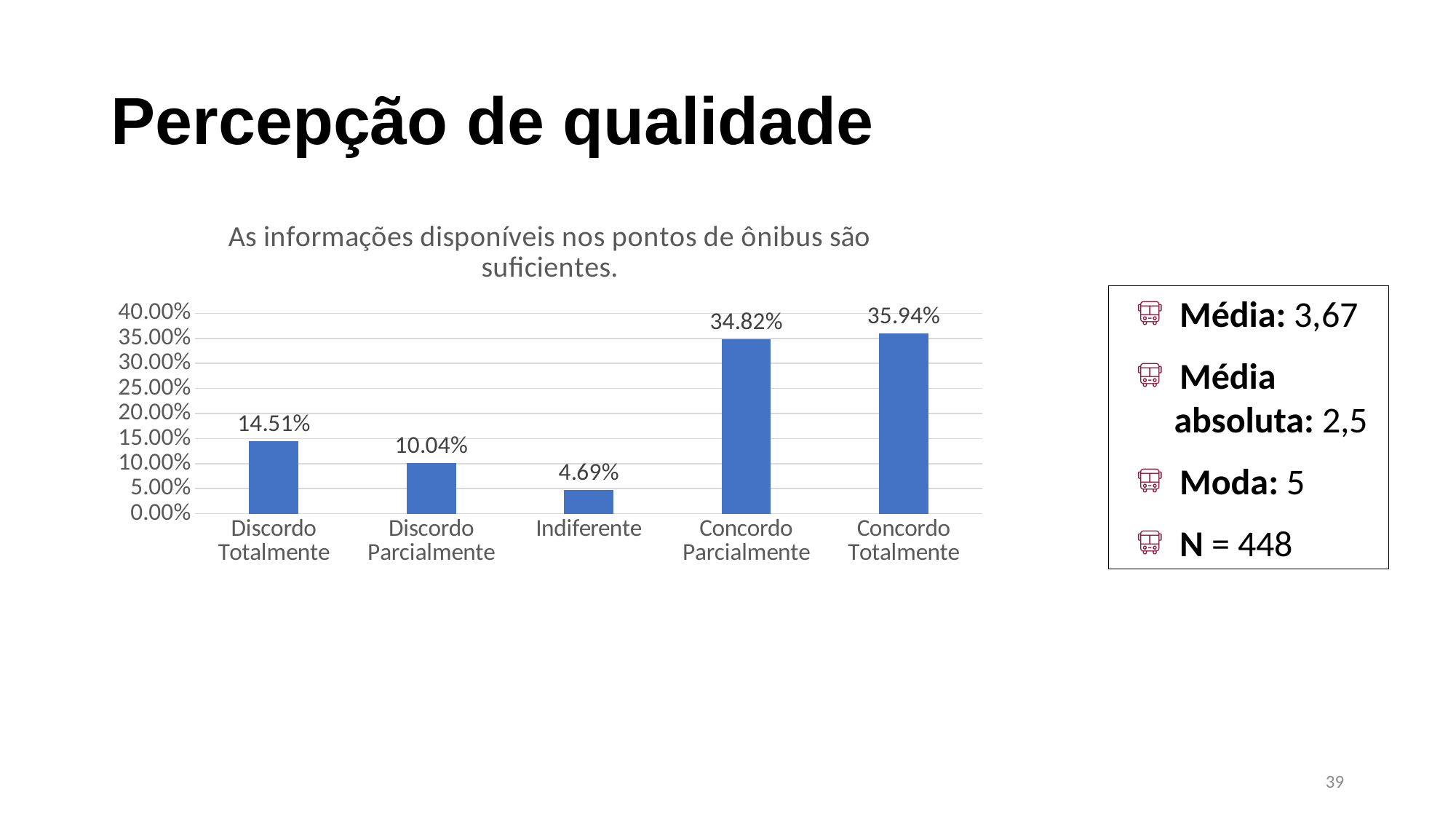
What is the difference between the values for Concordo Totalmente and Concordo Parcialmente? 1.12% What is the value for Discordo Totalmente? 14.51% Which is larger, the value for Discordo Totalmente or the value for Indiferente? Discordo Totalmente Is the value for Concordo Parcialmente greater or less than 30.00%? greater What is the title of the chart? As informações disponíveis nos pontos de ônibus são suficientes. What is the value for Concordo Parcialmente? 34.82% What is the value for Indiferente? 4.69% How many categories are shown on the x axis? 5 What is the difference between the values for Discordo Totalmente and Discordo Parcialmente? 4.47% What kind of chart is shown on the slide? bar chart Which category has the highest value? Concordo Totalmente Which category has the lowest value? Indiferente